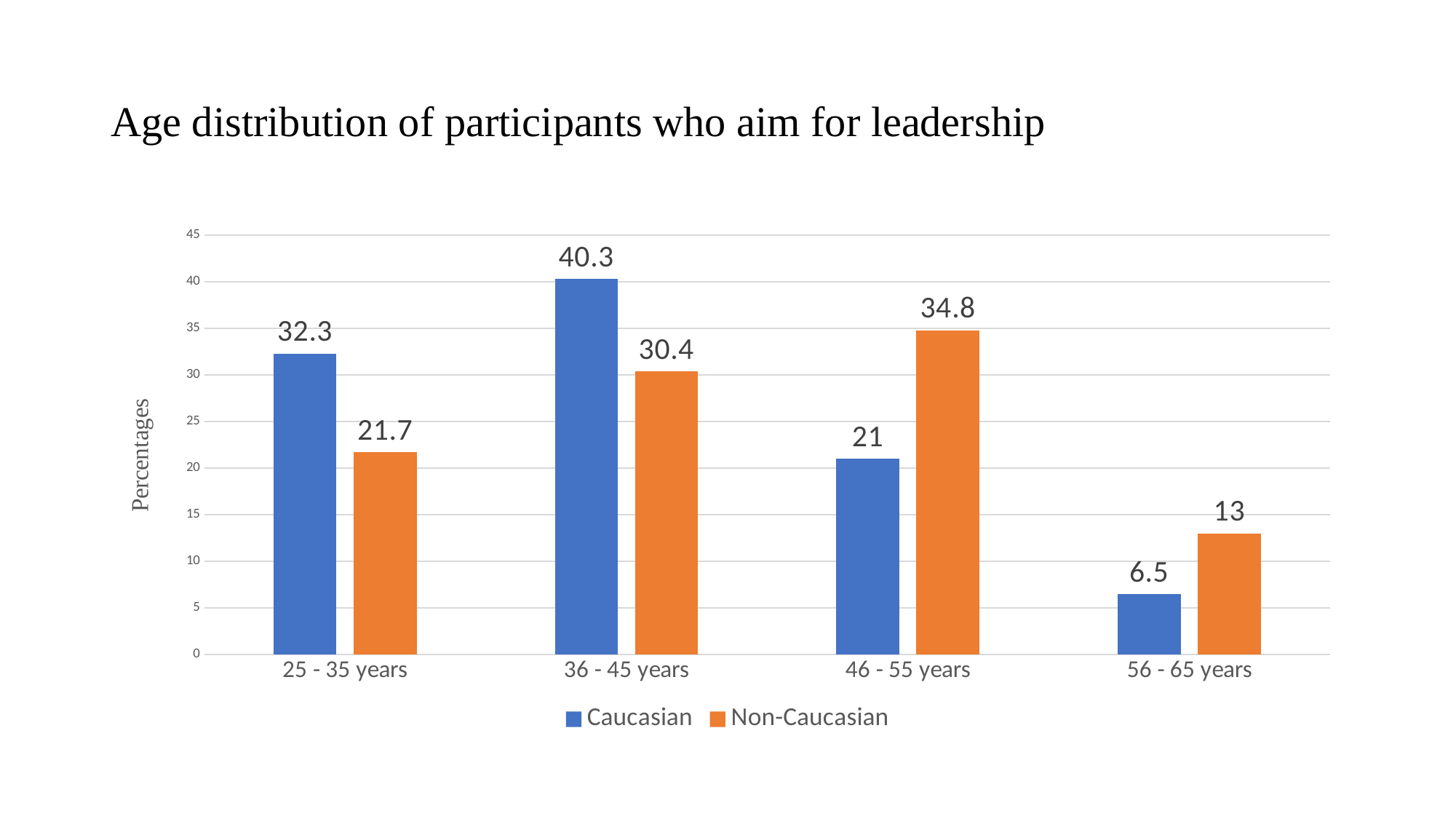
What is the Caucasian value for 36 - 45 years? 40.3 How many age groups are shown on the x axis? 4 What kind of chart is shown on the slide? Bar chart Which age group has the highest Caucasian value? 36 - 45 years Is the Non-Caucasian value for 36 - 45 years greater or less than 25? greater What is the label of the vertical axis? Percentages What is the Non-Caucasian value for 56 - 65 years? 13 What is the Non-Caucasian value for 25 - 35 years? 21.7 How many series does the legend list? 2 Which is larger for 25 - 35 years, the Caucasian or the Non-Caucasian value? Caucasian Which age group has the lowest Non-Caucasian value? 56 - 65 years What is the difference between the Caucasian and Non-Caucasian values for 46 - 55 years? 13.8